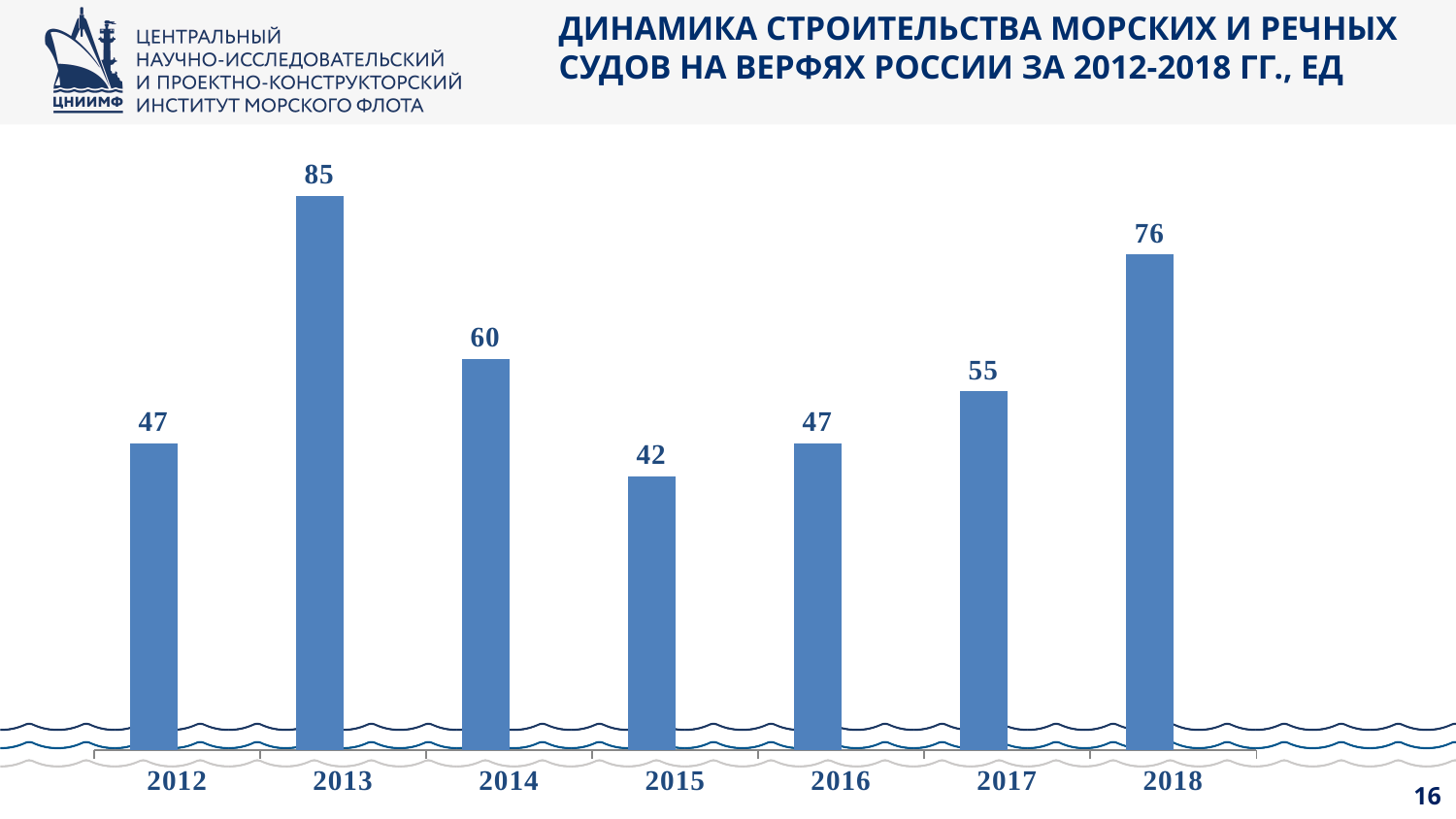
What is the difference between the values for 2018 and 2017? 21 Which two years have the same value? 2012 and 2016 Which is larger, the value for 2014 or the value for 2017? 2014 What is the value for 2015? 42 Do the values rise or fall from 2015 to 2018? rise What is the difference between the values for 2013 and 2012? 38 What kind of chart is this? bar chart How many years are shown on the x axis? 7 Which year has the lowest value? 2015 Which year has the highest value? 2013 What is the value for 2018? 76 What is the value for 2013? 85